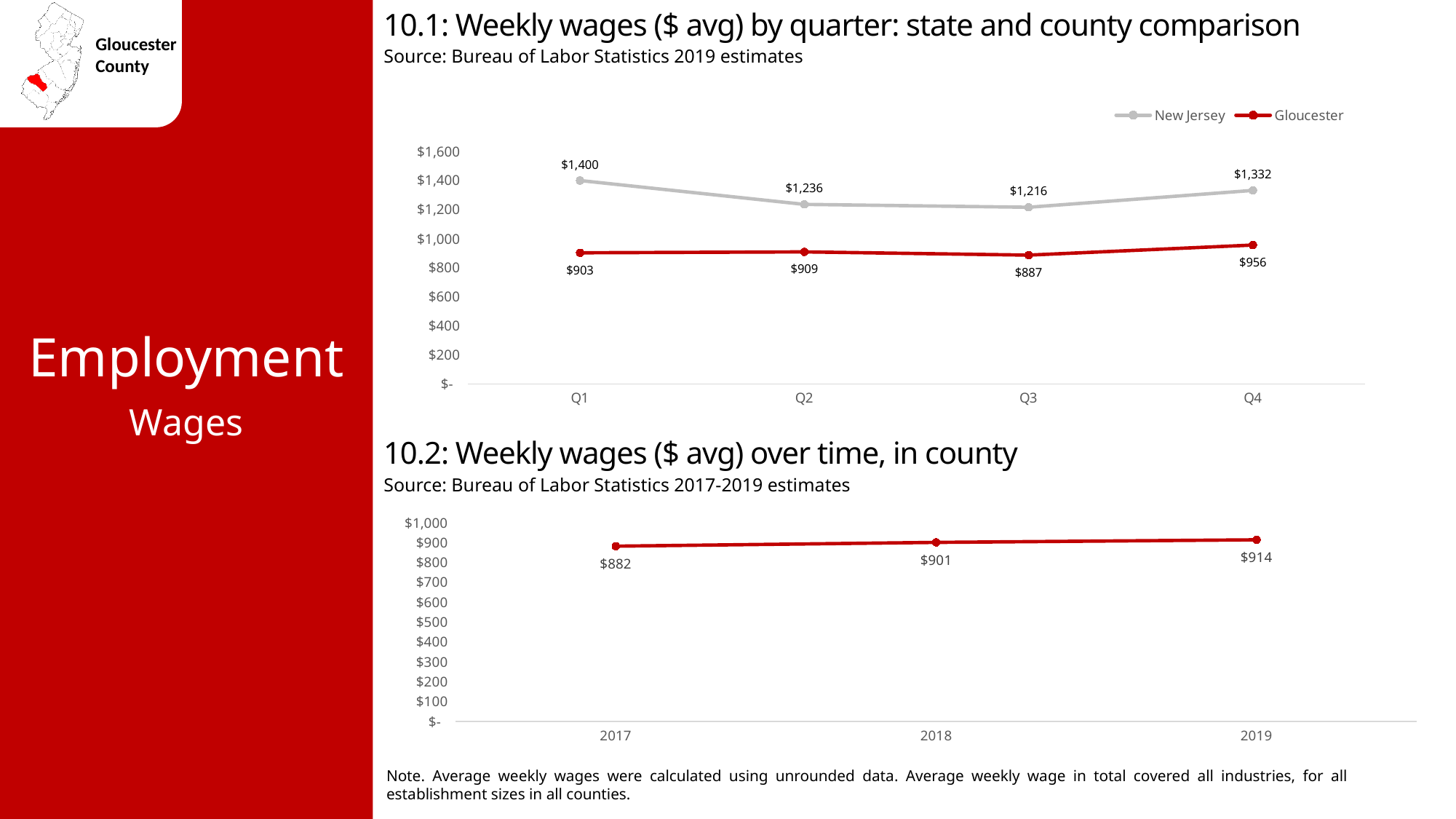
In chart 10.1, what is the Gloucester weekly wage in Q3? $887 What kind of chart is chart 10.2? Line chart In chart 10.1, what colour is the Gloucester line? Red In chart 10.1, in which quarter is the Gloucester weekly wage highest? Q4 In chart 10.1, how many series does the legend list? 2 In chart 10.1, what is the difference between the New Jersey and Gloucester weekly wages in Q4? $376 In chart 10.2, what is the difference between the 2019 and 2017 weekly wages? $32 In chart 10.2, do the weekly wages rise or fall from 2017 to 2019? Rise In chart 10.1, what is the New Jersey weekly wage in Q1? $1,400 In chart 10.2, what is the weekly wage in 2018? $901 In chart 10.1, which series has the higher weekly wage in Q2, New Jersey or Gloucester? New Jersey In chart 10.1, in which quarter is the New Jersey weekly wage lowest? Q3